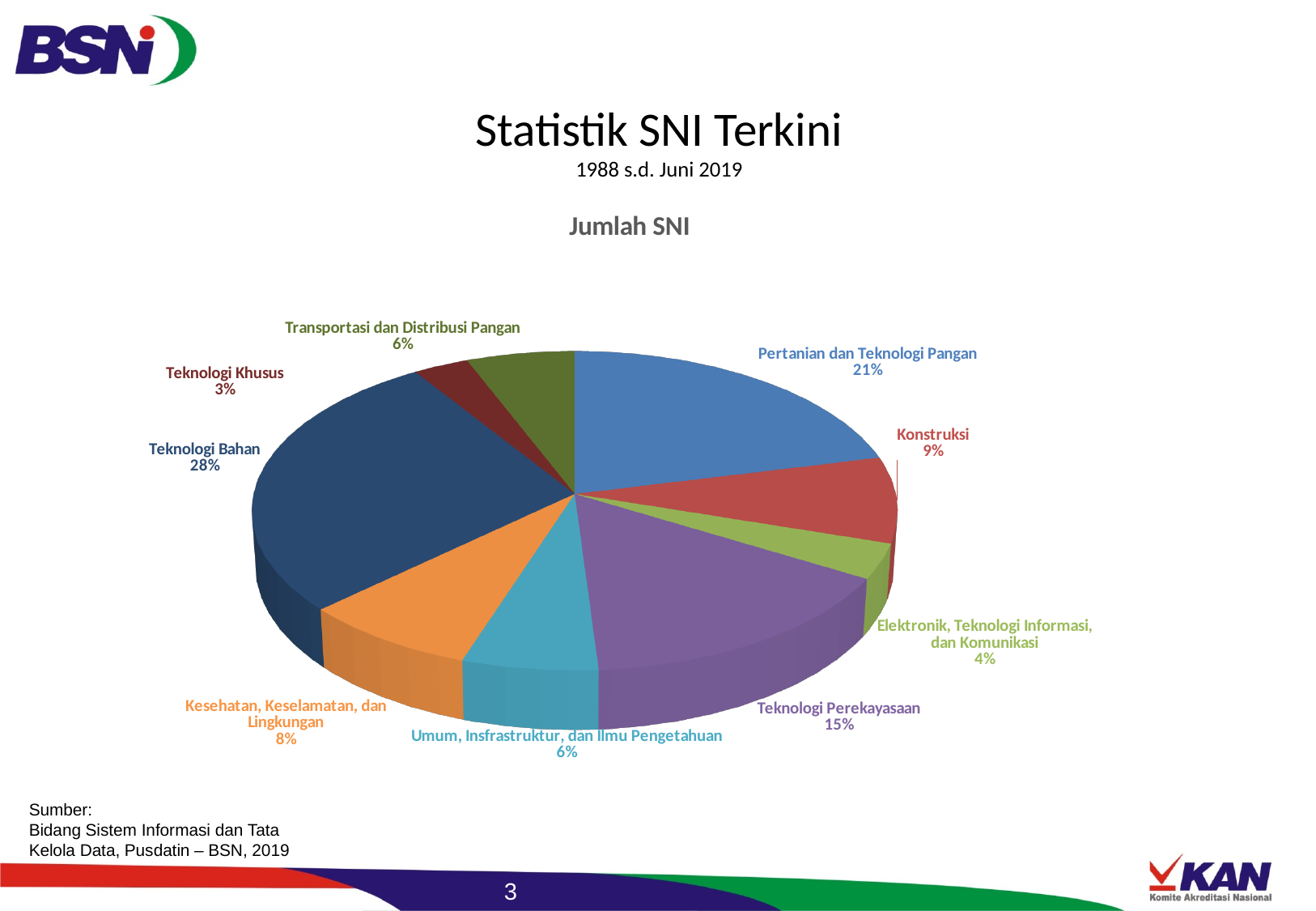
What is the title of the chart? Jumlah SNI How many categories (slices) does the pie chart have? 9 What percentage is shown for Transportasi dan Distribusi Pangan? 6% What percentage is shown for Teknologi Perekayasaan? 15% What share of the pie does Teknologi Bahan have? 28% Which category has the largest share of the pie? Teknologi Bahan What is the difference in percentage points between Teknologi Bahan and Pertanian dan Teknologi Pangan? 7 Which is larger: the share for Kesehatan, Keselamatan, dan Lingkungan or the share for Elektronik, Teknologi Informasi, dan Komunikasi? Kesehatan, Keselamatan, dan Lingkungan What percentage is shown for Pertanian dan Teknologi Pangan? 21% What kind of chart is shown on the slide? pie chart Which category has the smallest share of the pie? Teknologi Khusus What percentage is shown for Konstruksi? 9%